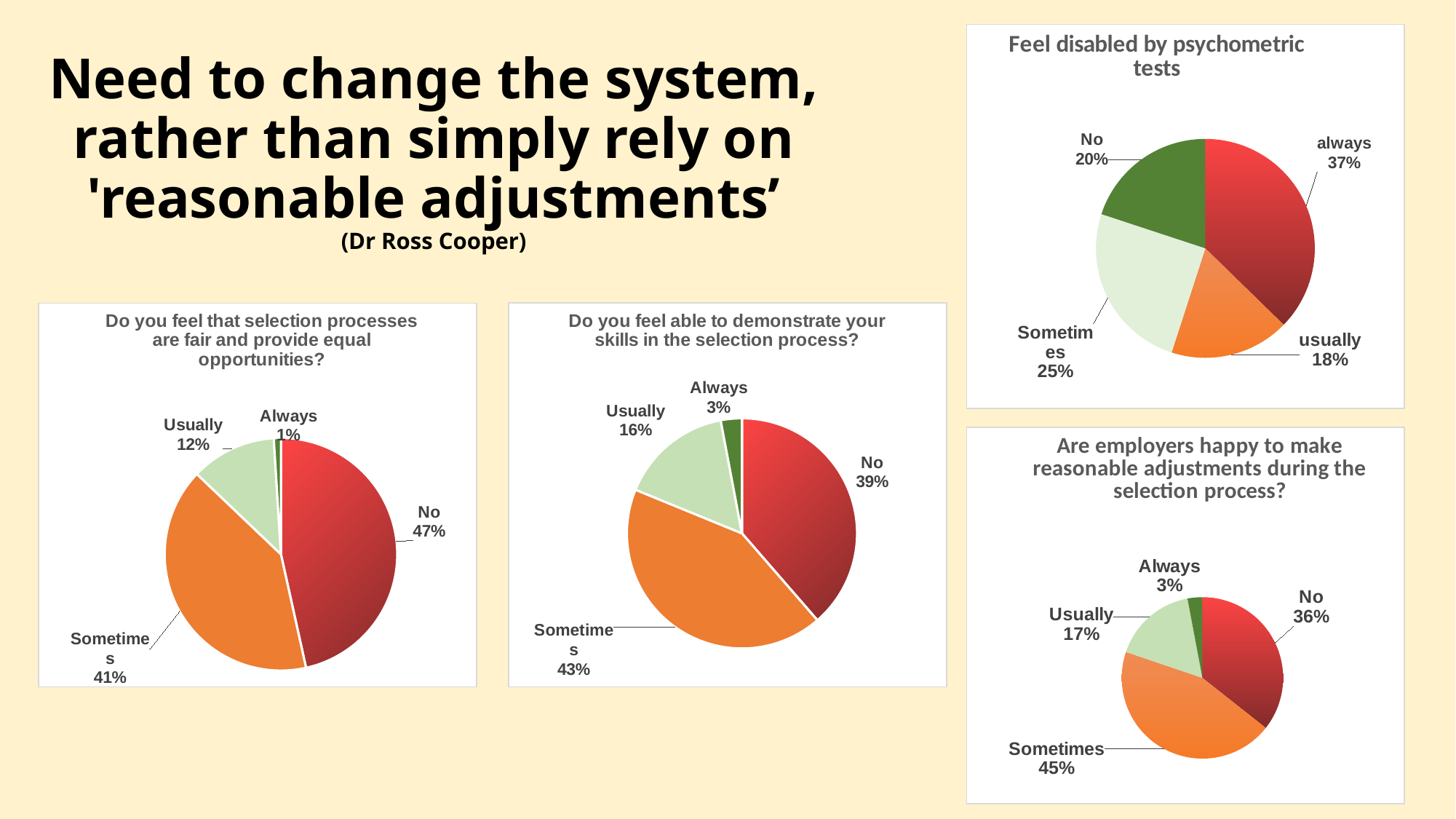
In the chart 'Are employers happy to make reasonable adjustments during the selection process?', what share answered 'Usually'? 17% In the chart 'Are employers happy to make reasonable adjustments during the selection process?', which is larger, the 'Sometimes' share or the 'No' share? Sometimes In the chart 'Do you feel able to demonstrate your skills in the selection process?', what share answered 'Sometimes'? 43% In the chart 'Do you feel that selection processes are fair and provide equal opportunities?', what share of respondents answered 'No'? 47% In the chart 'Do you feel able to demonstrate your skills in the selection process?', what is the difference between the 'Sometimes' and 'No' shares? 4% In the chart 'Feel disabled by psychometric tests', how many slices does the pie have? 4 In the chart 'Feel disabled by psychometric tests', which response has the smallest share? usually In the chart 'Do you feel able to demonstrate your skills in the selection process?', which response has the largest share? Sometimes How many charts are shown on the slide? 4 In the chart 'Do you feel that selection processes are fair and provide equal opportunities?', which response has the smallest share? Always What type of chart is used for 'Are employers happy to make reasonable adjustments during the selection process?' Pie chart In the chart 'Feel disabled by psychometric tests', what share answered 'always'? 37%